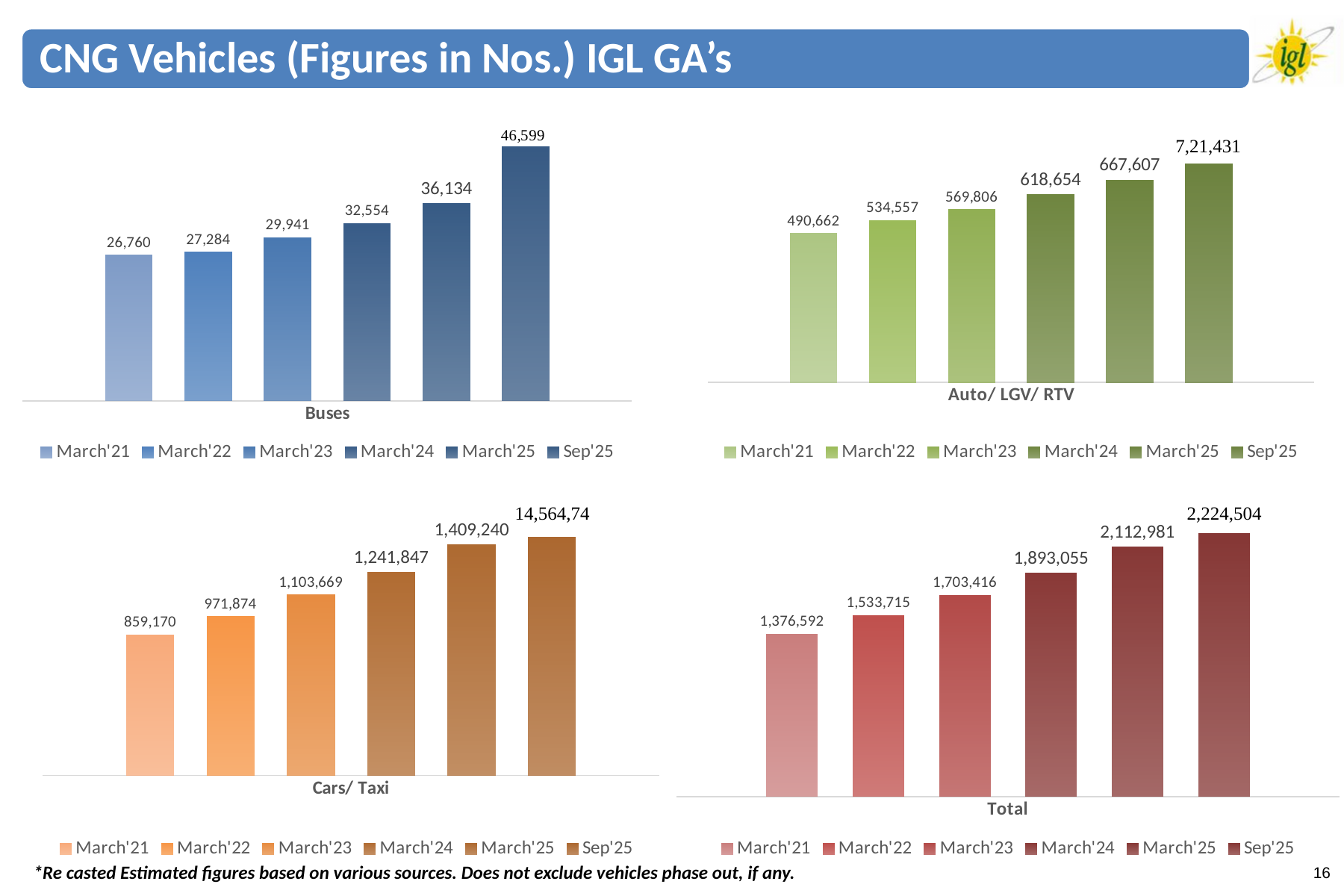
How many series does the legend of the Auto/ LGV/ RTV chart list? 6 In the Buses chart, what is the value for March'25? 36,134 What type of chart is the Total chart? Bar chart In the Buses chart, what is the difference between the March'25 and March'24 values? 3,580 In the Buses chart, what is the value for March'21? 26,760 In the Total chart, what is the difference between the March'22 and March'21 values? 157,123 In the Buses chart, which period has the highest value? Sep'25 In the Auto/ LGV/ RTV chart, what is the value for March'24? 618,654 In the Cars/ Taxi chart, what is the value for March'23? 1,103,669 In the Total chart, which period has the lowest value? March'21 In the Total chart, what is the value for Sep'25? 2,224,504 In the Cars/ Taxi chart, which is larger, the value for March'24 or March'22? March'24